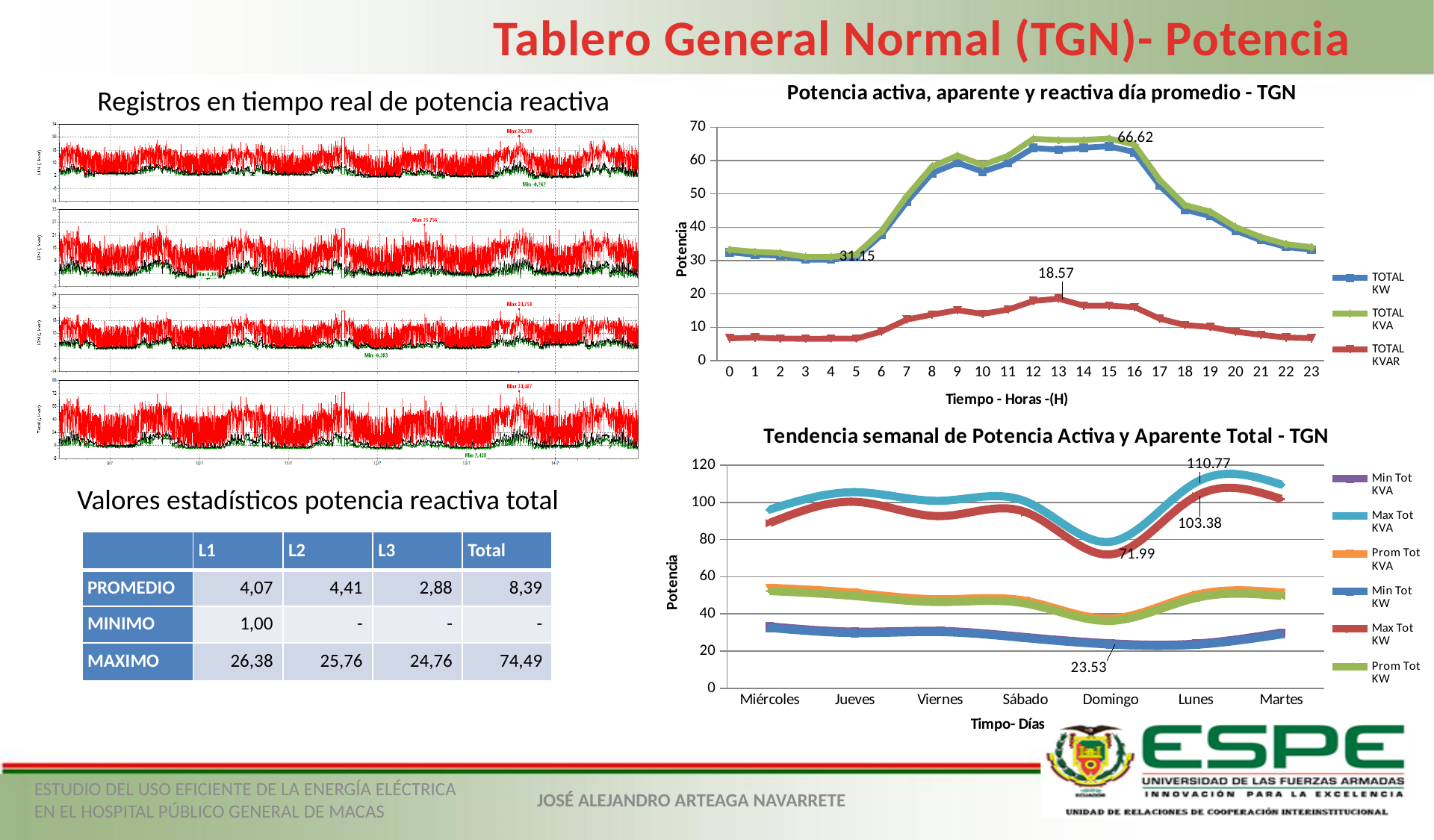
In the chart 'Potencia activa, aparente y reactiva día promedio - TGN', how many series does the legend list? 3 In the chart 'Potencia activa, aparente y reactiva día promedio - TGN', is the TOTAL KVAR value at hour 0 greater or less than 10? less In the chart 'Potencia activa, aparente y reactiva día promedio - TGN', what is the labelled peak value of TOTAL KVAR? 18.57 In the chart 'Tendencia semanal de Potencia Activa y Aparente Total - TGN', what is the difference between the labelled Max Tot KVA (110.77) and Max Tot KW (103.38) values on Lunes? 7.39 In the chart 'Tendencia semanal de Potencia Activa y Aparente Total - TGN', on which day is Max Tot KW lowest? Domingo In the chart 'Potencia activa, aparente y reactiva día promedio - TGN', how many hour points are shown on the x axis? 24 In the chart 'Tendencia semanal de Potencia Activa y Aparente Total - TGN', what is the labelled value of Max Tot KVA on Lunes? 110.77 In the chart 'Tendencia semanal de Potencia Activa y Aparente Total - TGN', how many days are shown on the x axis? 7 In the chart 'Potencia activa, aparente y reactiva día promedio - TGN', does TOTAL KVAR rise or fall from hour 16 to hour 23? Fall In the chart 'Potencia activa, aparente y reactiva día promedio - TGN', what value is labelled on the TOTAL KVA line at hour 16? 66.62 In the chart 'Tendencia semanal de Potencia Activa y Aparente Total - TGN', how many series does the legend list? 6 What kind of chart is 'Potencia activa, aparente y reactiva día promedio - TGN'? Line chart